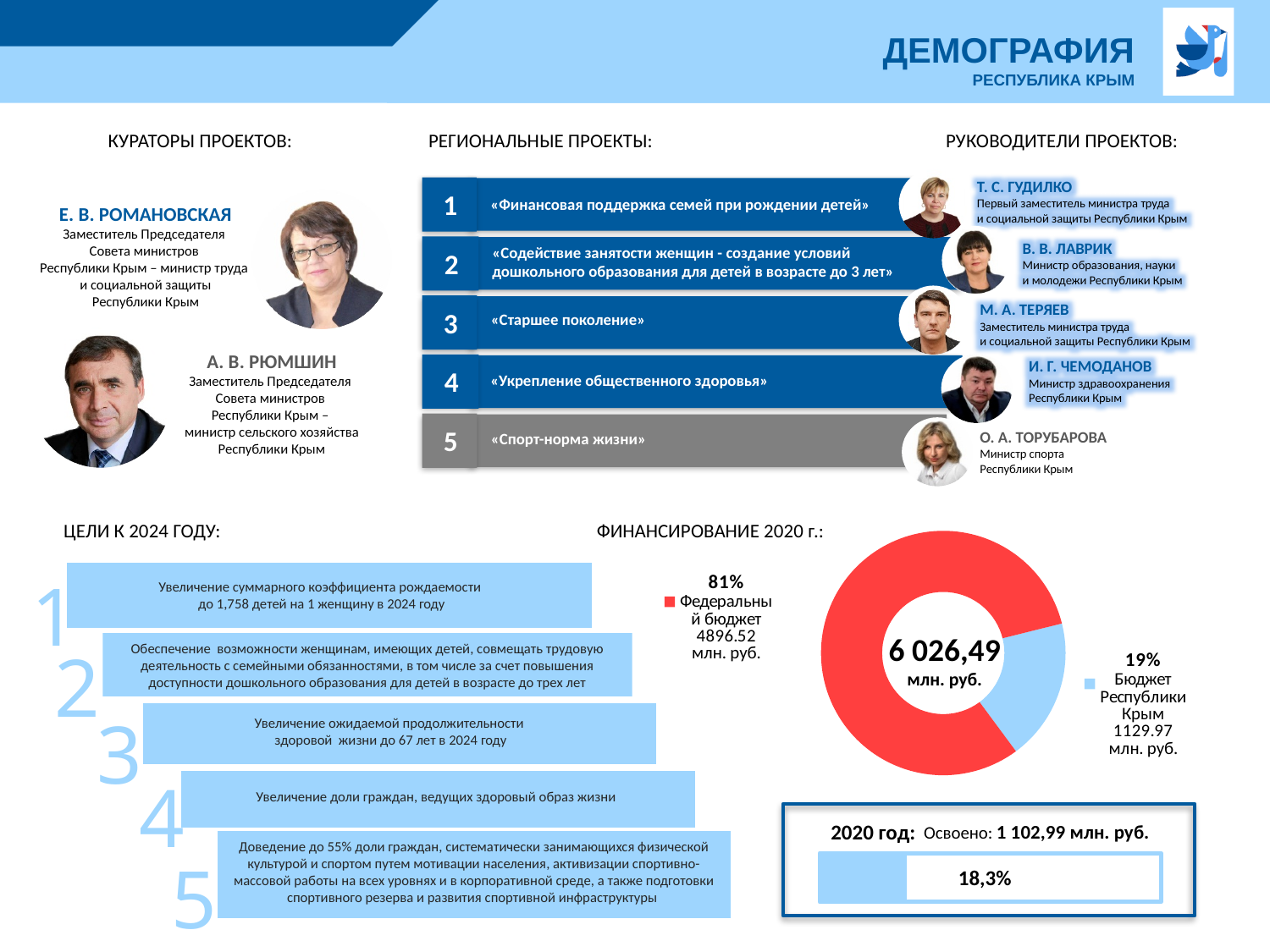
How many slices does the ФИНАНСИРОВАНИЕ 2020 г. donut chart have? 2 What kind of chart is shown under the heading ФИНАНСИРОВАНИЕ 2020 г.? Donut (pie) chart In the ФИНАНСИРОВАНИЕ 2020 г. chart, what is the value for the Федеральный бюджет in млн. руб.? 4896.52 млн. руб. In the ФИНАНСИРОВАНИЕ 2020 г. chart, which is larger: the Федеральный бюджет or the Бюджет Республики Крым? Федеральный бюджет In the ФИНАНСИРОВАНИЕ 2020 г. chart, what colour is the Федеральный бюджет slice? Red In the ФИНАНСИРОВАНИЕ 2020 г. chart, what is the value for the Бюджет Республики Крым in млн. руб.? 1129.97 млн. руб. In the ФИНАНСИРОВАНИЕ 2020 г. chart, which funding source is the largest? Федеральный бюджет What total amount is shown in the centre of the ФИНАНСИРОВАНИЕ 2020 г. donut chart? 6 026,49 млн. руб. In the ФИНАНСИРОВАНИЕ 2020 г. chart, what share of funding comes from the Бюджет Республики Крым? 19% In the ФИНАНСИРОВАНИЕ 2020 г. chart, what share of funding comes from the Федеральный бюджет? 81% In the ФИНАНСИРОВАНИЕ 2020 г. chart, which funding source is the smallest? Бюджет Республики Крым In the ФИНАНСИРОВАНИЕ 2020 г. chart, what is the difference in percentage points between the Федеральный бюджет share and the Бюджет Республики Крым share? 62 percentage points